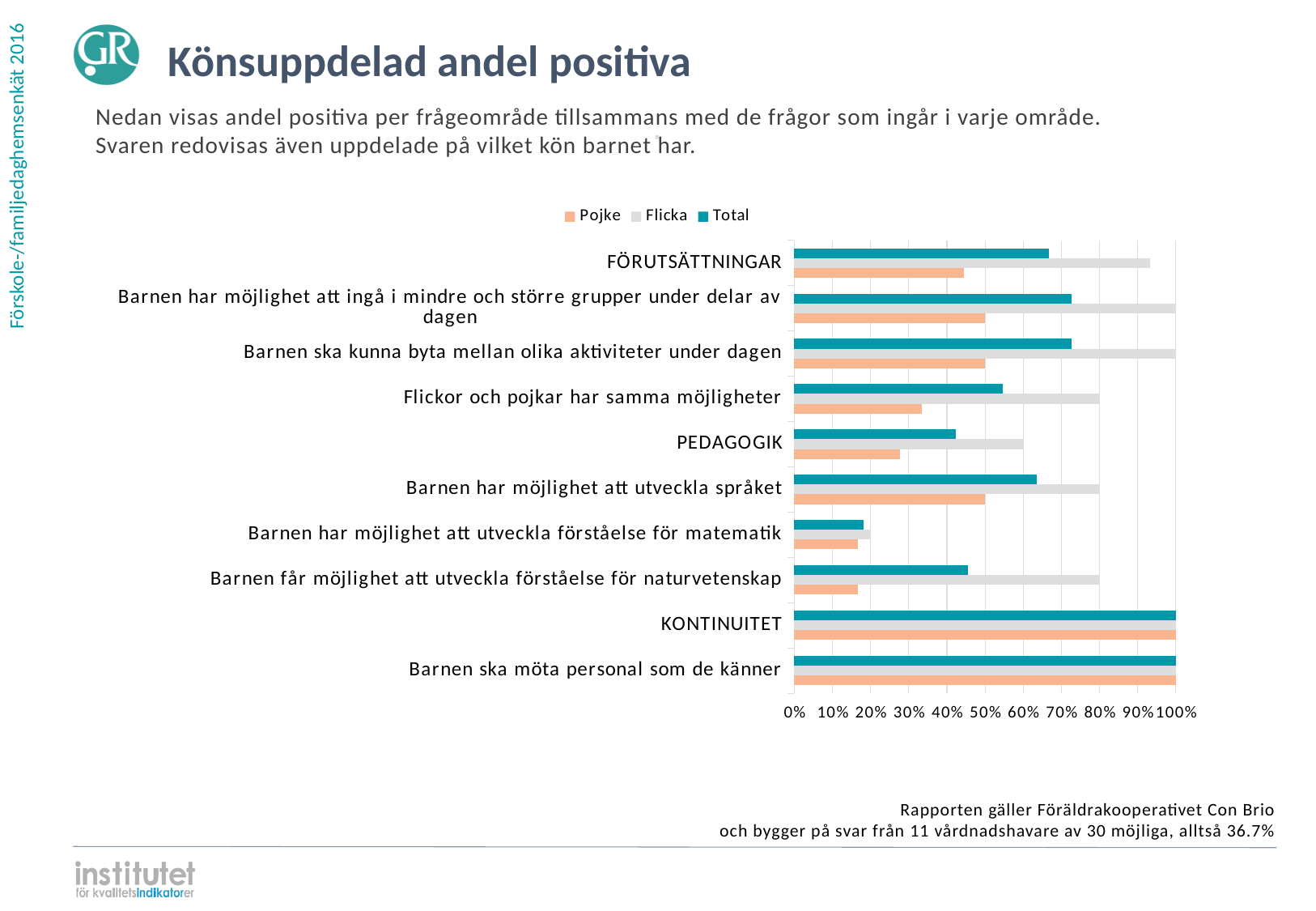
What is the Flicka value for 'Barnen ska kunna byta mellan olika aktiviteter under dagen'? 100% Is the Total value for 'Barnen har möjlighet att utveckla förståelse för matematik' greater or less than 30%? less Is the Pojke value for FÖRUTSÄTTNINGAR greater or less than 50%? less Which category has the lowest Total value? Barnen har möjlighet att utveckla förståelse för matematik What kind of chart is shown on the slide? Bar chart How many series does the legend list? 3 Is the Flicka value for FÖRUTSÄTTNINGAR greater or less than 80%? greater What is the Total value for KONTINUITET? 100% How many categories are plotted on the y axis of the chart? 10 What is the Pojke value for 'Barnen ska möta personal som de känner'? 100% For 'Barnen får möjlighet att utveckla förståelse för naturvetenskap', which is larger: the Flicka value or the Pojke value? Flicka